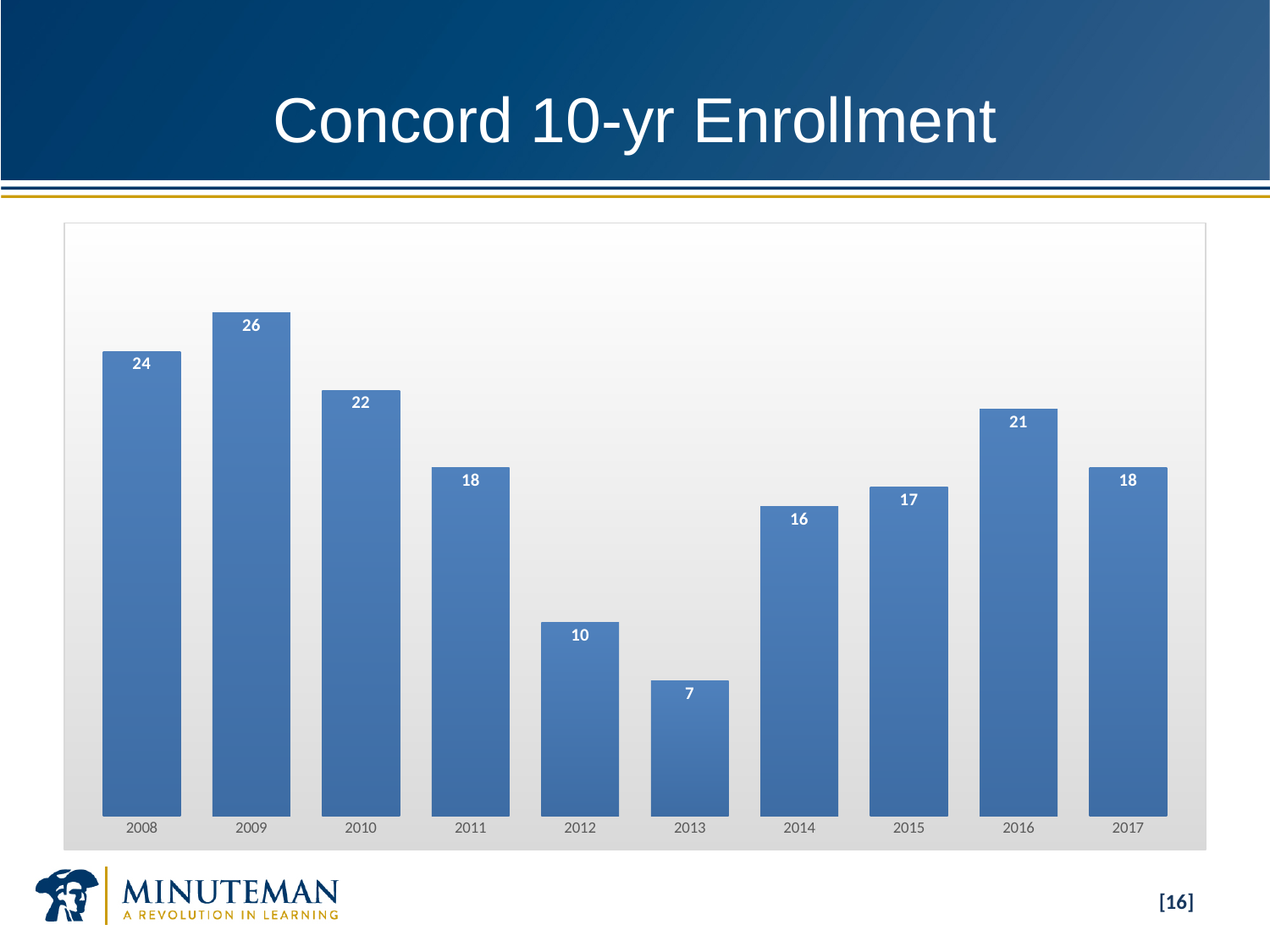
How many years are shown on the chart? 10 Which year has the highest enrollment? 2009 Which year has the lowest enrollment? 2013 Which year has the larger enrollment, 2012 or 2017? 2017 What is the enrollment value for 2009? 26 What is the difference between the enrollment in 2009 and 2013? 19 What is the enrollment value for 2016? 21 What is the enrollment value for 2013? 7 What is the difference between the enrollment in 2008 and 2010? 2 What kind of chart is shown on the slide? Bar chart Which year has the larger enrollment, 2014 or 2015? 2015 Does enrollment rise or fall from 2009 to 2013? Fall